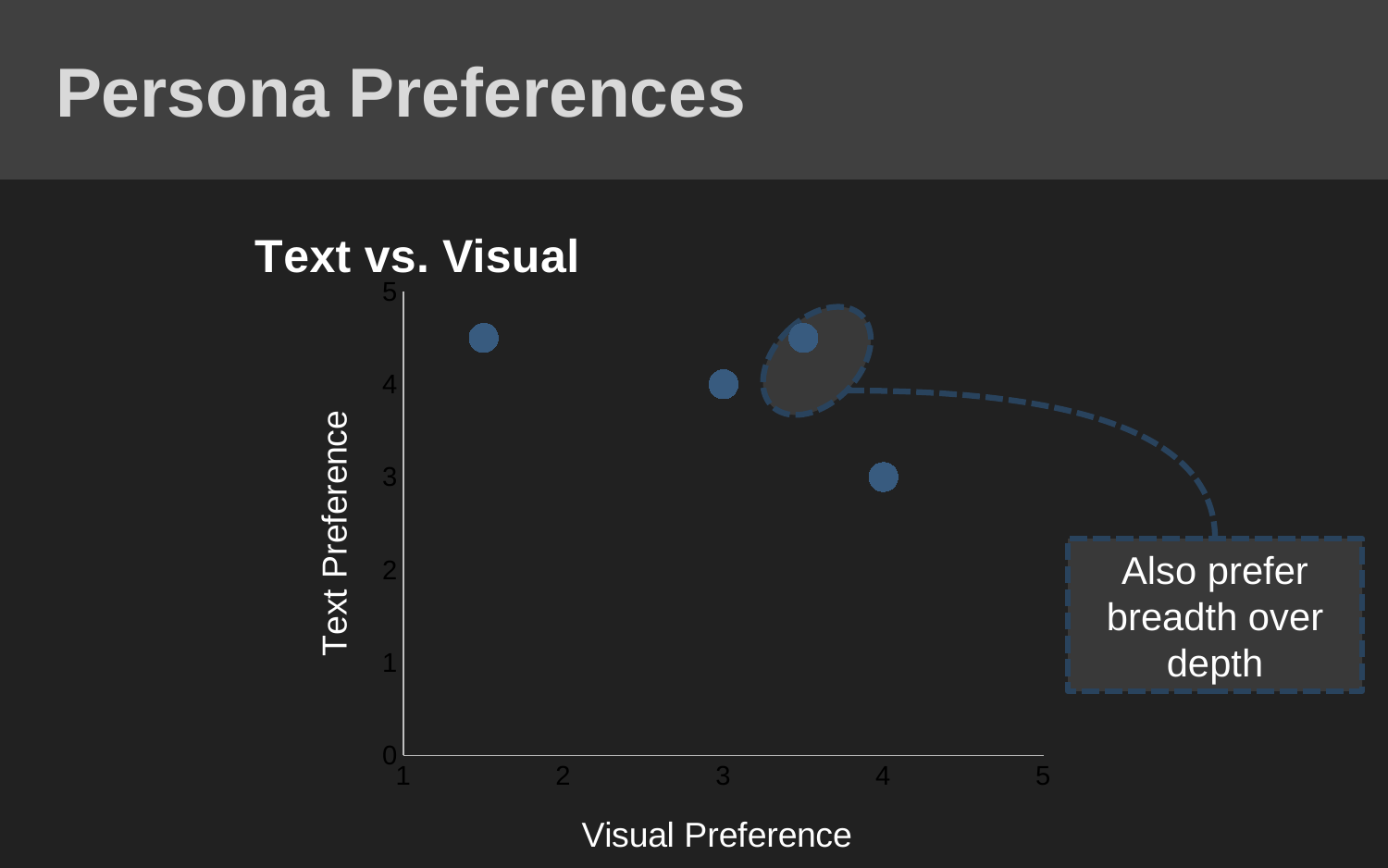
Which has the higher Text Preference: the point at Visual Preference 3 or the point at Visual Preference 4? the point at Visual Preference 3 What is the Text Preference value of the point at Visual Preference 4? 3 How many points have a Text Preference greater than 4? 2 Is the Visual Preference of the leftmost point greater or less than 2? less Is the Text Preference of the leftmost point greater or less than 4? greater What is the label of the horizontal axis? Visual Preference What is the Text Preference value of the point at Visual Preference 3? 4 What kind of chart is shown on the slide? scatter chart What is the title of the chart? Text vs. Visual Which point has the lowest Text Preference? the point at Visual Preference 4 What is the highest value shown on the Visual Preference axis? 5